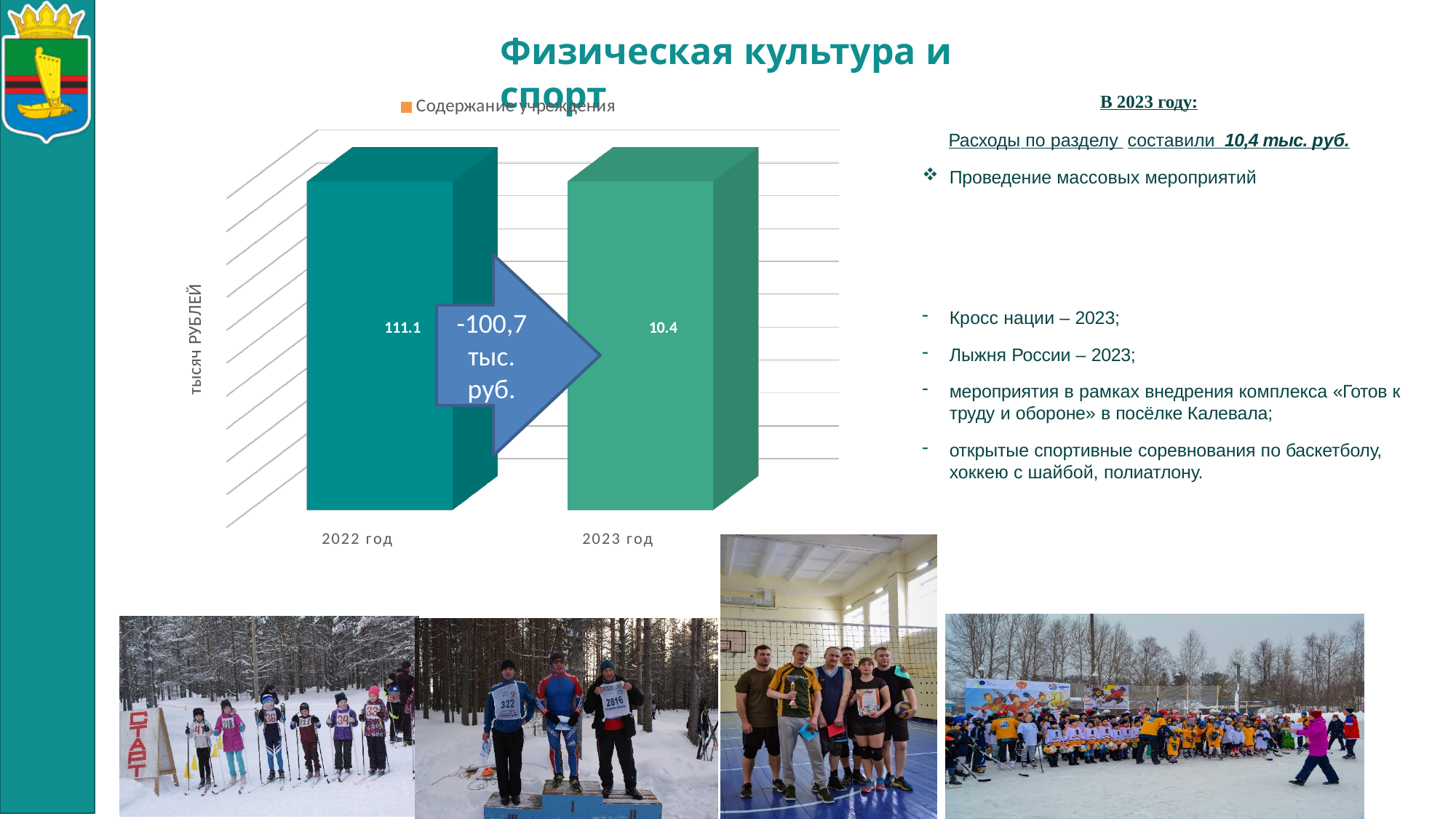
Which is larger, the value for 2022 год or the value for 2023 год? 2022 год What is the difference between the values for 2022 год and 2023 год? 100.7 What is the value for 2022 год? 111.1 Which year has the lowest value? 2023 год What is the value for 2023 год? 10.4 How many categories are shown on the x axis? 2 What kind of chart is shown? bar chart What series name is shown in the legend? Содержание учреждения Do the values rise or fall from 2022 год to 2023 год? fall Which year has the highest value? 2022 год What is the label on the vertical axis? тысяч РУБЛЕЙ How many series does the legend list? 1